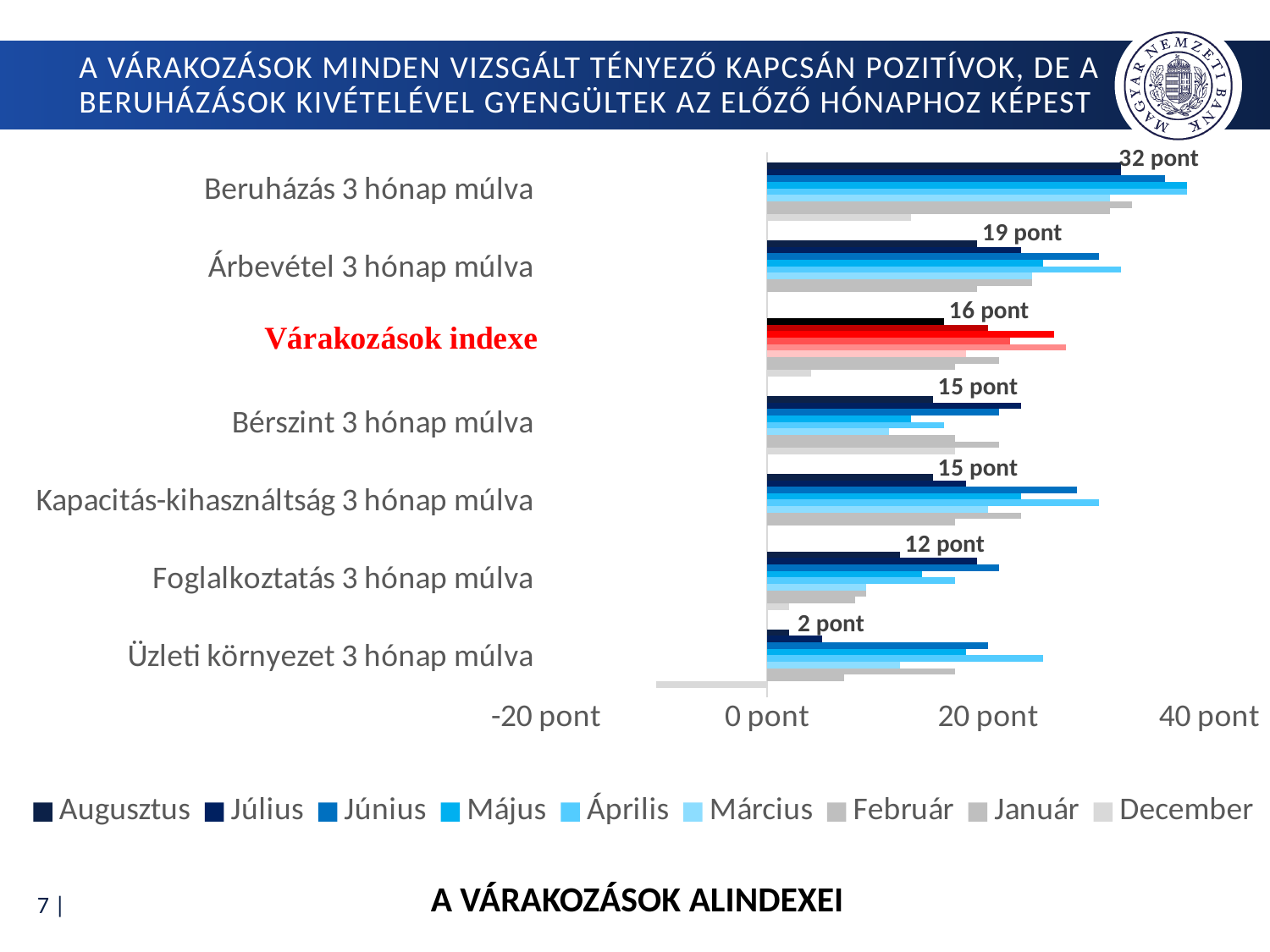
Which has the larger Augusztus value, Árbevétel 3 hónap múlva or Foglalkoztatás 3 hónap múlva? Árbevétel 3 hónap múlva Is the December value for Üzleti környezet 3 hónap múlva greater or less than 0 pont? less Which category has the highest Augusztus value? Beruházás 3 hónap múlva How many series does the legend list? 9 What is the Augusztus value for Üzleti környezet 3 hónap múlva? 2 pont What is the Augusztus value for Árbevétel 3 hónap múlva? 19 pont What is the Augusztus value for Várakozások indexe? 16 pont What is the difference between the Augusztus values for Beruházás 3 hónap múlva and Árbevétel 3 hónap múlva? 13 pont What is the Augusztus value for Beruházás 3 hónap múlva? 32 pont How many categories are shown on the chart? 7 What kind of chart is shown on the slide? bar chart Which category has the lowest Augusztus value? Üzleti környezet 3 hónap múlva